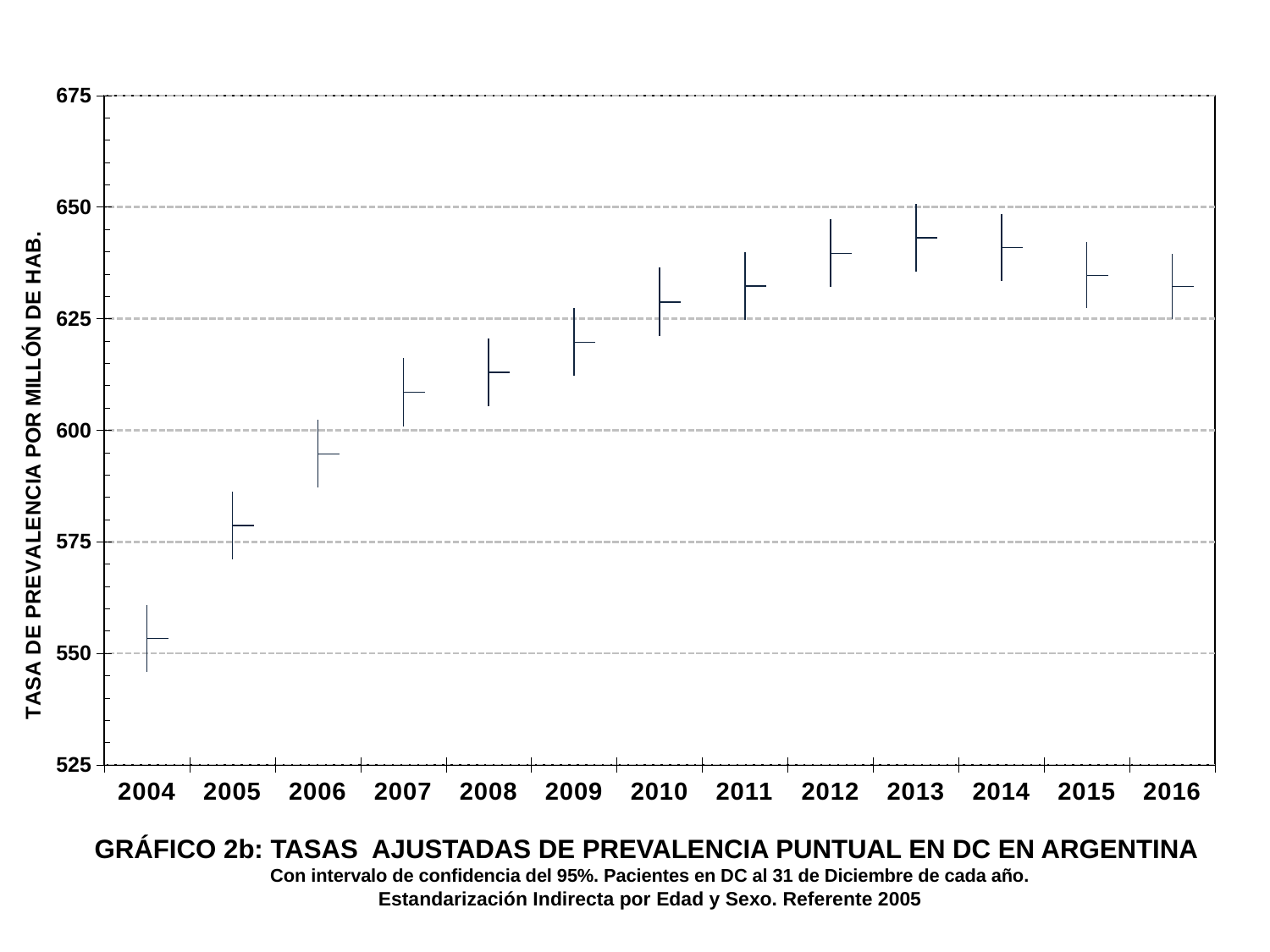
Is the value for 2004 greater or less than 550? greater Which year has the lowest adjusted prevalence rate? 2004 What is the label of the y axis? TASA DE PREVALENCIA POR MILLÓN DE HAB. Is the value for 2006 greater or less than 600? less Is the value for 2007 greater or less than 600? greater How many years are plotted on the x axis? 13 Do the values generally rise or fall from 2004 to 2013? rise Which is larger, the value for 2005 or the value for 2010? 2010 What kind of chart is shown on the slide? Scatter (point) chart with confidence interval bars Which is larger, the value for 2008 or the value for 2012? 2012